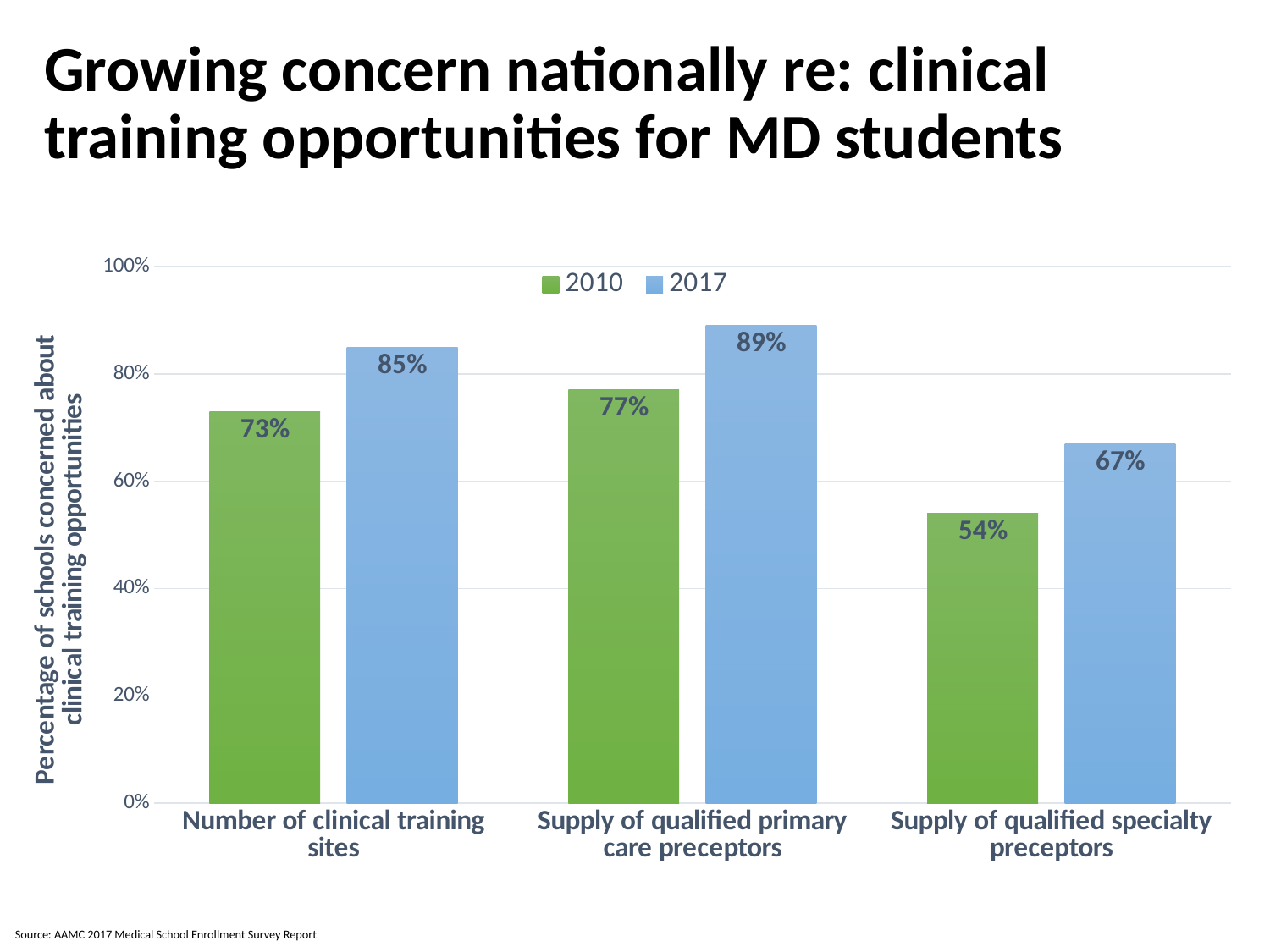
Which is larger: the 2010 value for supply of qualified primary care preceptors or the 2017 value for supply of qualified specialty preceptors? 2010 value for supply of qualified primary care preceptors Which category has the highest value in the 2017 series? Supply of qualified primary care preceptors How many categories are shown on the x axis? 3 What colour represents the 2017 series? Blue What is the difference between the 2017 and 2010 values for number of clinical training sites? 12 How many series does the legend list? 2 What percentage of schools were concerned about the number of clinical training sites in 2010? 73% What is the 2017 value for supply of qualified specialty preceptors? 67% What percentage of schools were concerned about the supply of qualified primary care preceptors in 2017? 89% Which category has the lowest value in the 2010 series? Supply of qualified specialty preceptors What kind of chart is shown on the slide? Bar chart By how many percentage points did concern about the supply of qualified specialty preceptors increase from 2010 to 2017? 13